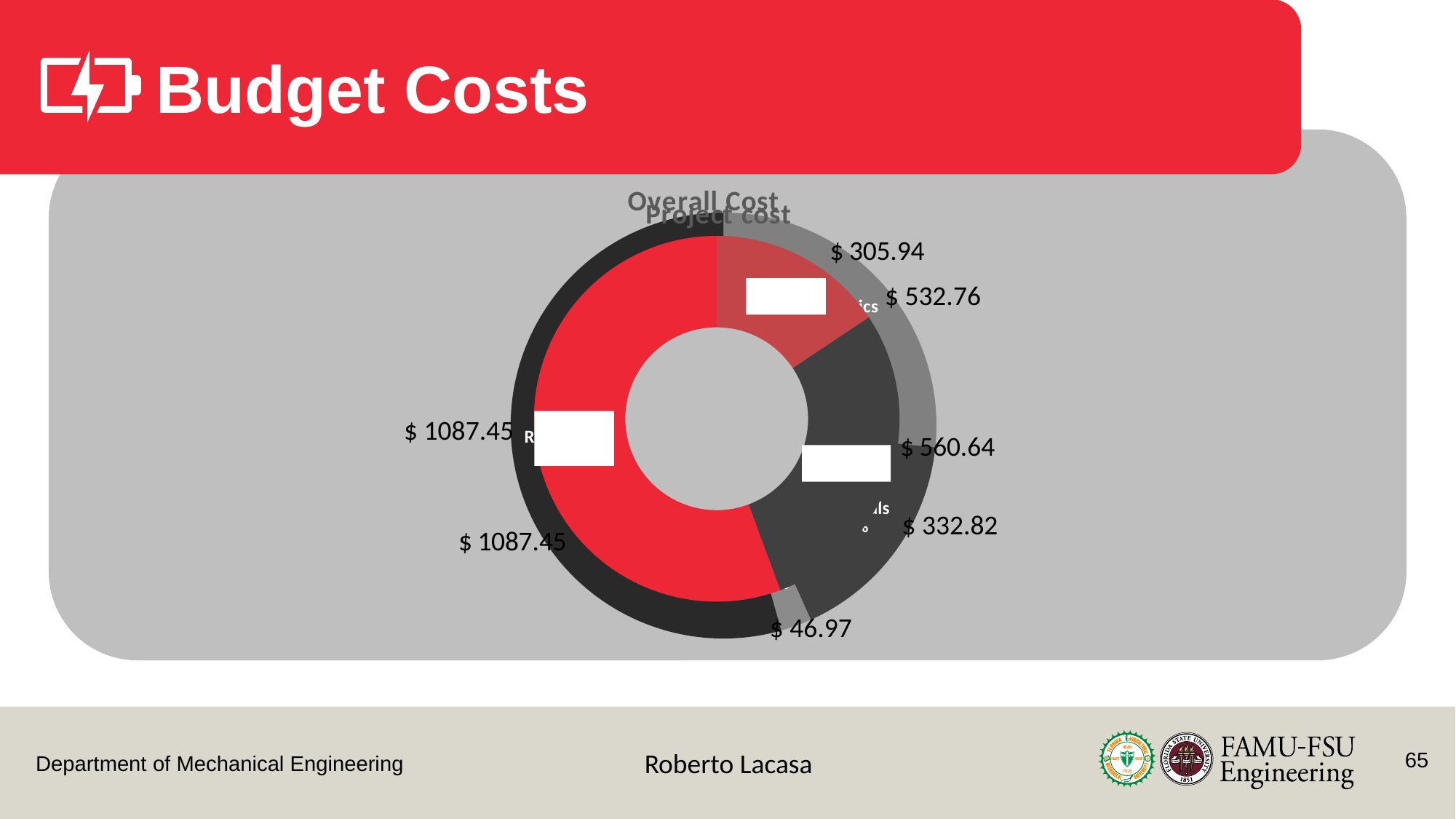
What title appears at the top of the chart in the larger grey text? Overall Cost Which is larger, the value labelled $ 305.94 or the value labelled $ 332.82? $ 332.82 What is the difference between the values labelled $ 560.64 and $ 532.76? $ 27.88 Which is larger, the value labelled $ 560.64 or the value labelled $ 532.76? $ 560.64 How many data value labels are printed on the chart? 7 What kind of chart is shown on the slide? doughnut chart What second title overlaps the chart title just below it? Project cost What is the difference between the values labelled $ 332.82 and $ 46.97? $ 285.85 What is the largest value printed on the chart? $ 1087.45 What is the smallest value printed on the chart? $ 46.97